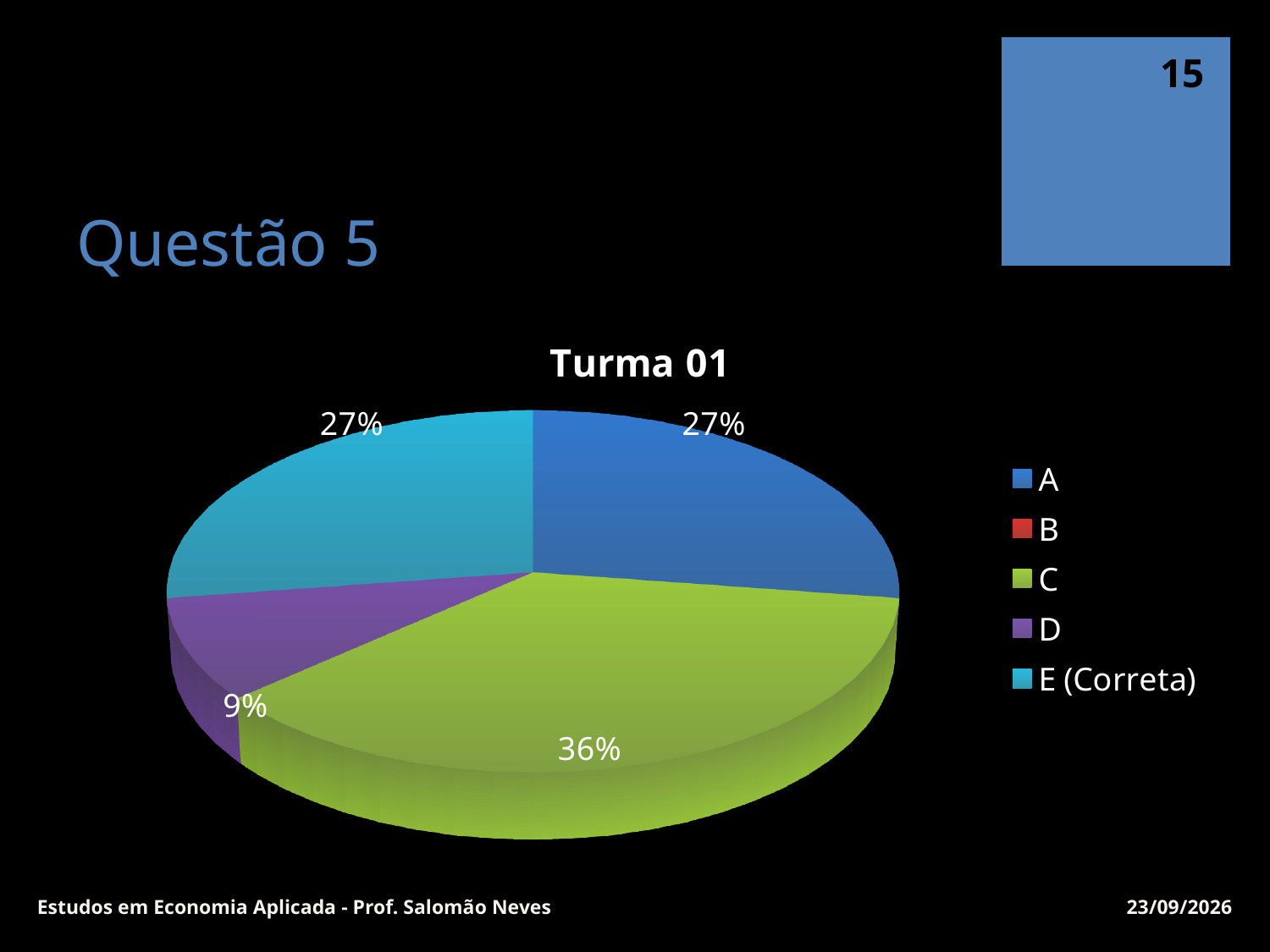
What percentage of the pie does slice D represent? 9% What percentage of the pie does slice A represent? 27% What kind of chart is shown on the slide? pie chart What percentage of the pie does slice C represent? 36% What is the title of the chart? Turma 01 What percentage of the pie does the slice E (Correta) represent? 27% Which is larger, the slice for C or the slice for A? C How many entries does the legend list? 5 Which category has the largest slice of the pie? C Which legend entry is marked as the correct answer? E (Correta) Which visible slice of the pie is the smallest? D What is the difference in percentage points between slice C and slice D? 27